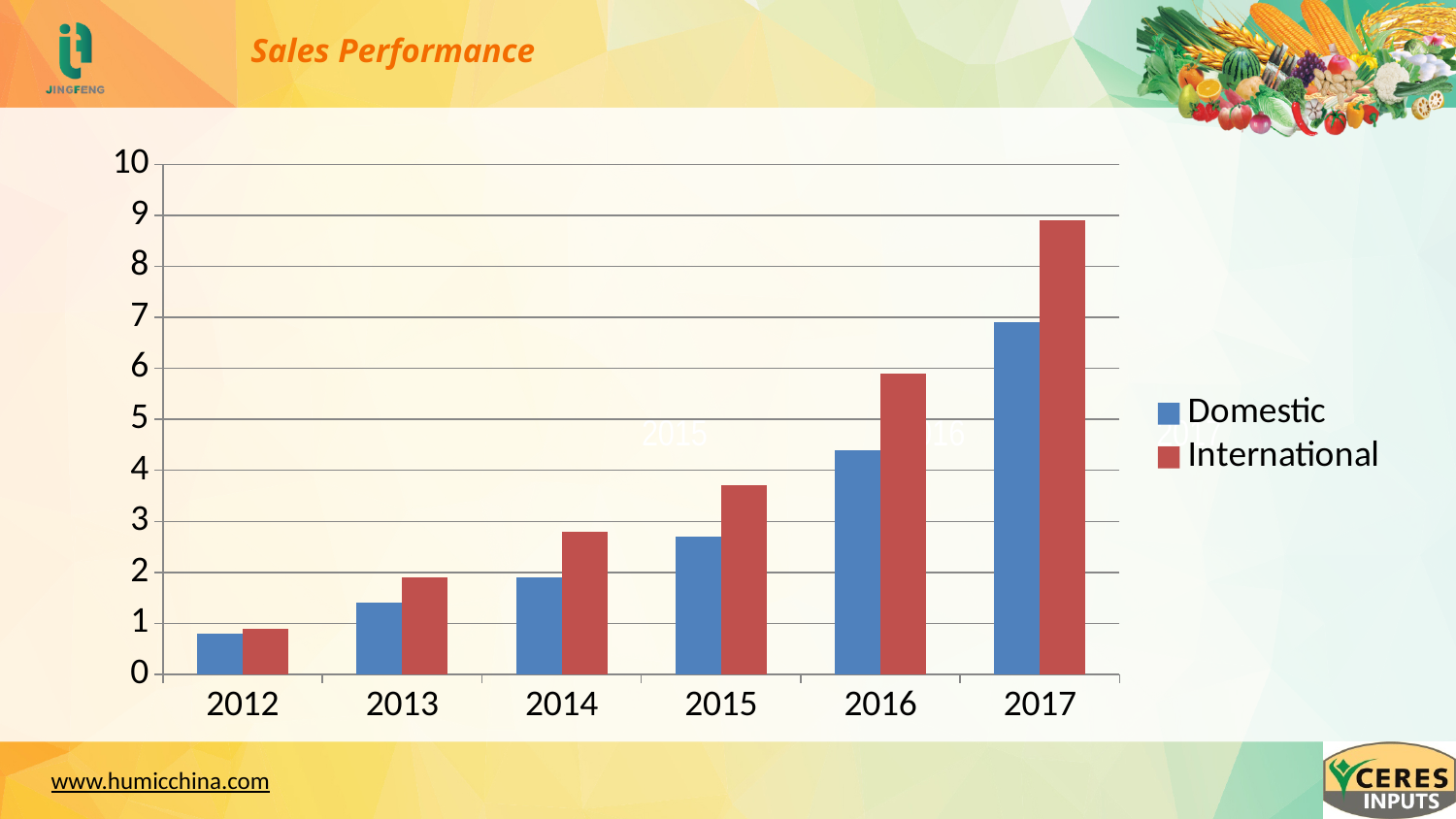
What is the title of the chart? Sales Performance Is the Domestic value for 2017 greater or less than 6? greater In which year is the International value highest? 2017 In 2017, which is larger, Domestic or International? International What kind of chart is shown on the slide? Bar chart How many series does the legend list? 2 In which year is the Domestic value lowest? 2012 Is the Domestic value for 2016 greater or less than 5? less Which series is shown in red? International Is the International value for 2015 greater or less than 3? greater How many years are shown on the x axis? 6